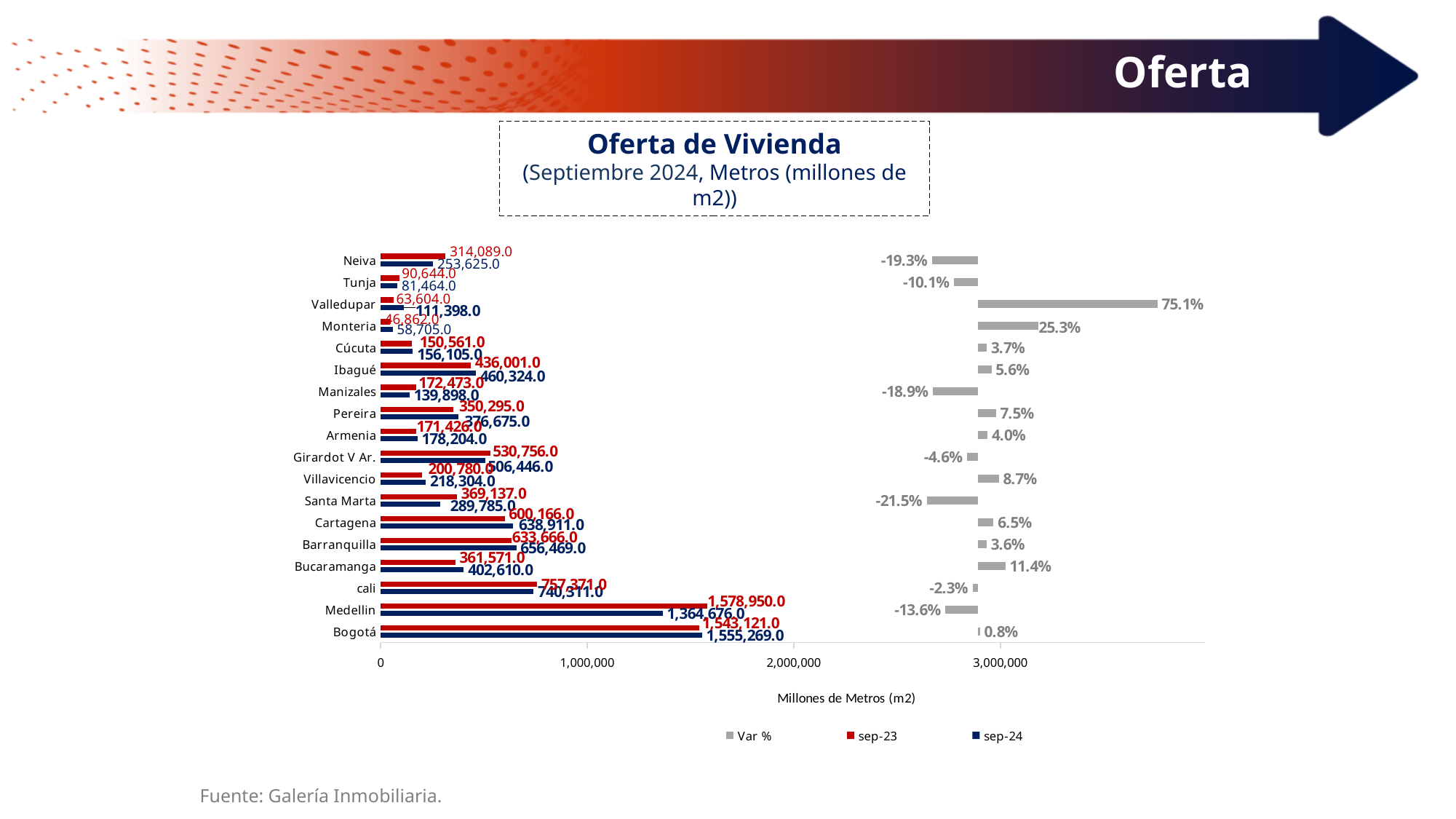
What is the Var % value for Valledupar? 75.1% How many cities are shown on the chart? 18 What is the sep-24 value for Bogotá? 1,555,269.0 Is the sep-23 value for cali greater or less than 1,000,000? less What is the sep-23 value for Medellin? 1,578,950.0 What is the difference between the sep-23 and sep-24 values for Neiva? 60,464.0 Which is larger for Medellin, the sep-23 value or the sep-24 value? sep-23 What kind of chart is this? bar chart How many series does the legend list? 3 Which city has the lowest Var % value? Santa Marta Which city has the highest sep-24 value? Bogotá Which city has the highest Var % value? Valledupar